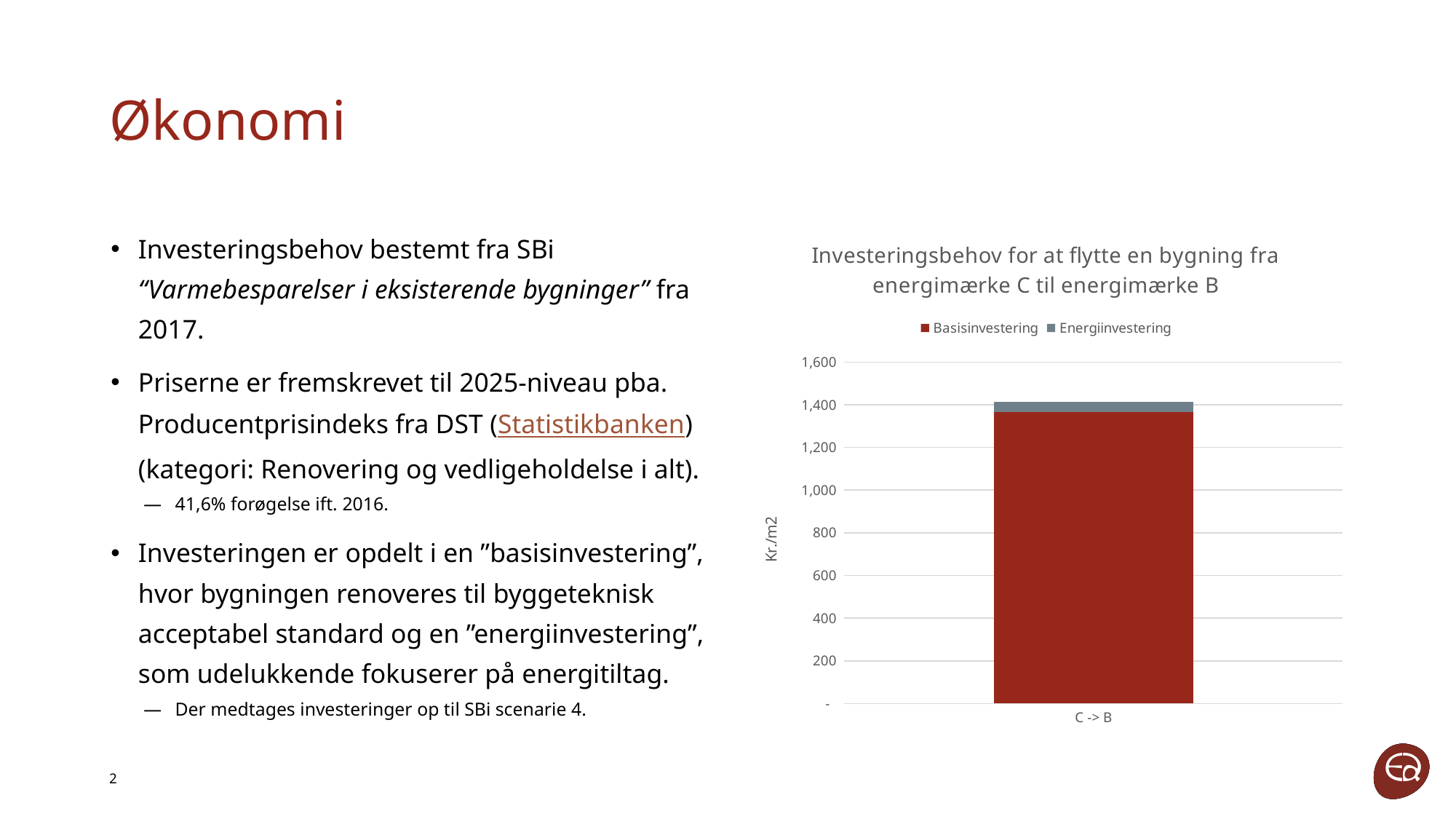
How many categories are shown on the x axis of the chart? 1 Is the Basisinvestering value for C -> B greater or less than 1,200? greater What kind of chart is shown on the slide? Stacked bar chart Which series is larger for the C -> B bar, Basisinvestering or Energiinvestering? Basisinvestering What is the label of the category on the x axis of the chart? C -> B Is the total height of the C -> B stacked bar greater or less than 1,600? less How many series does the chart's legend list? 2 What is the label on the y axis of the chart? Kr./m2 Is the Energiinvestering value for C -> B greater or less than 200? less